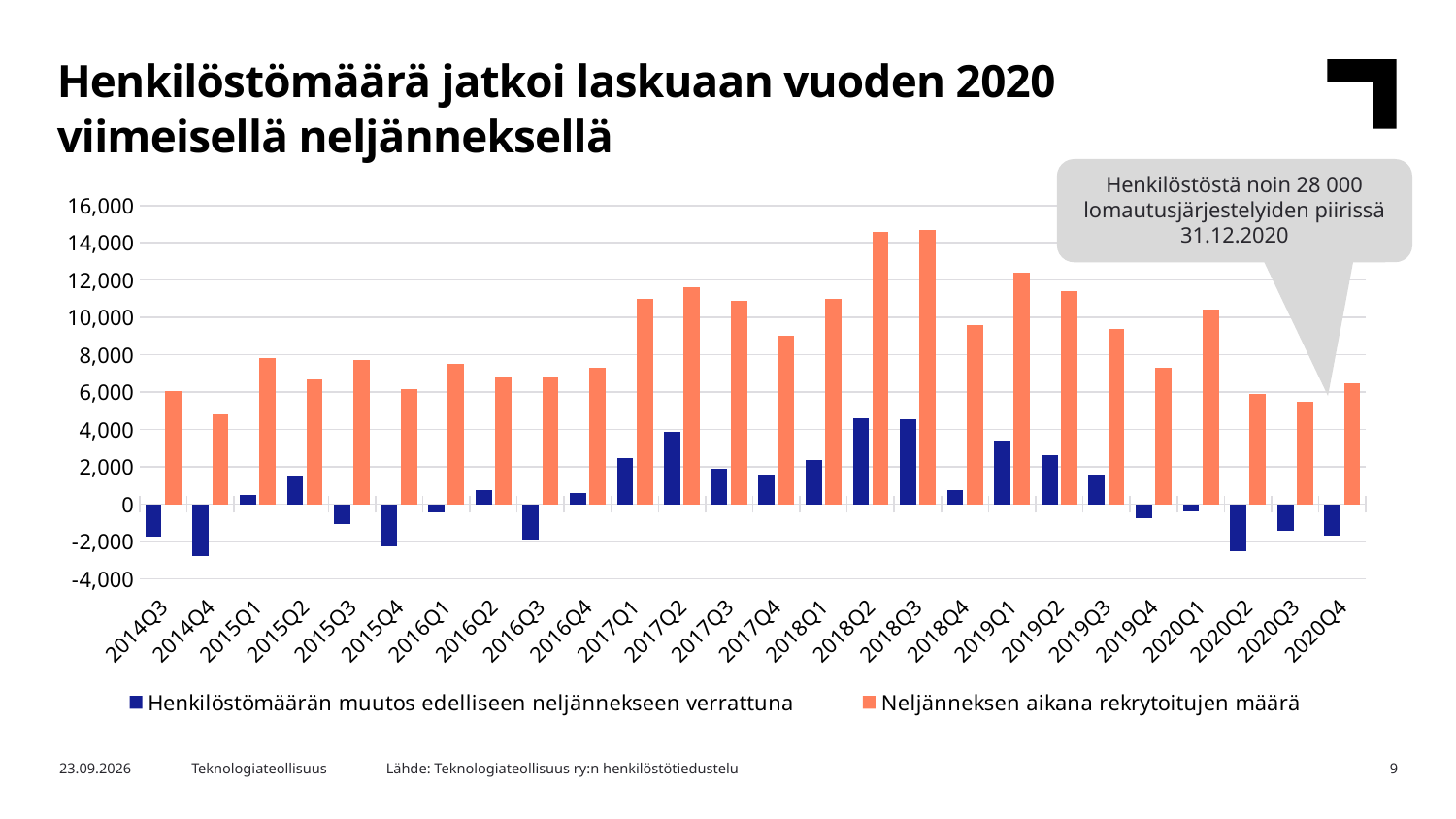
Is the value for 'Henkilöstömäärän muutos edelliseen neljännekseen verrattuna' in 2020Q2 greater or less than -2,000? less Is the value for 'Neljänneksen aikana rekrytoitujen määrä' in 2018Q2 greater or less than 14,000? greater According to the callout on the chart, about how many employees were covered by lay-off arrangements on 31.12.2020? noin 28 000 How many series does the legend list? 2 Is the value for 'Neljänneksen aikana rekrytoitujen määrä' in 2020Q3 greater or less than 6,000? less Which quarter has the larger value for 'Neljänneksen aikana rekrytoitujen määrä', 2017Q1 or 2016Q4? 2017Q1 How many quarters are shown on the x axis? 26 Does the value for 'Henkilöstömäärän muutos edelliseen neljännekseen verrattuna' rise or fall from 2019Q1 to 2020Q2? fall Which series is shown in orange? Neljänneksen aikana rekrytoitujen määrä What kind of chart is shown on the slide? bar chart Which quarter has the lowest value for 'Neljänneksen aikana rekrytoitujen määrä'? 2014Q4